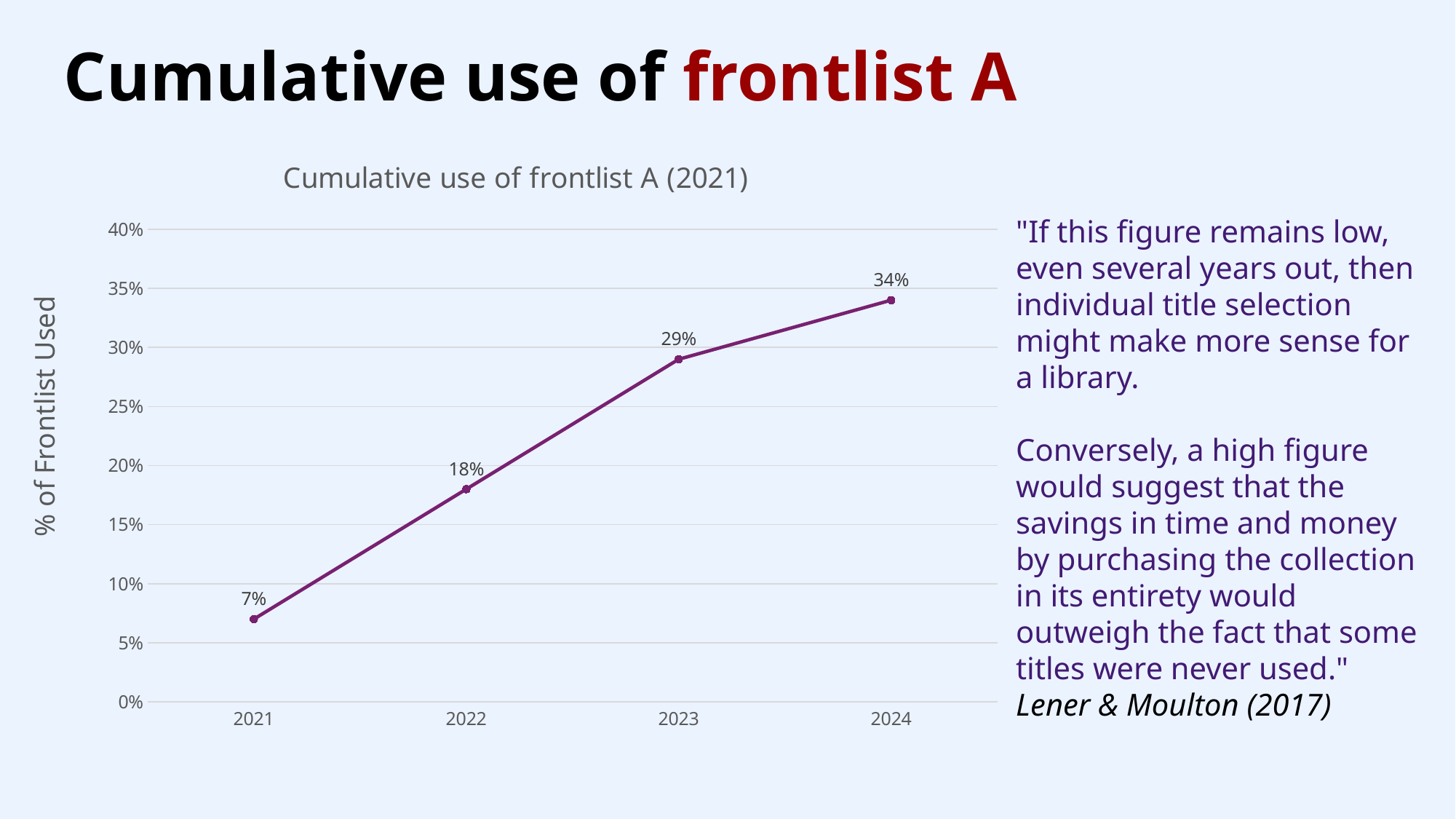
Which year has the highest cumulative use of frontlist A? 2024 What kind of chart is shown on the slide? Line chart What is the cumulative use of frontlist A in 2024? 34% Do the values rise or fall from 2021 to 2024? Rise How many years are plotted on the chart? 4 What is the cumulative use of frontlist A in 2022? 18% What is the difference in cumulative use between 2023 and 2022? 11% Which year has a higher cumulative use, 2022 or 2023? 2023 What is the difference in cumulative use between 2024 and 2021? 27% Which year has the lowest cumulative use of frontlist A? 2021 What is the cumulative use of frontlist A in 2023? 29% What is the cumulative use of frontlist A in 2021? 7%